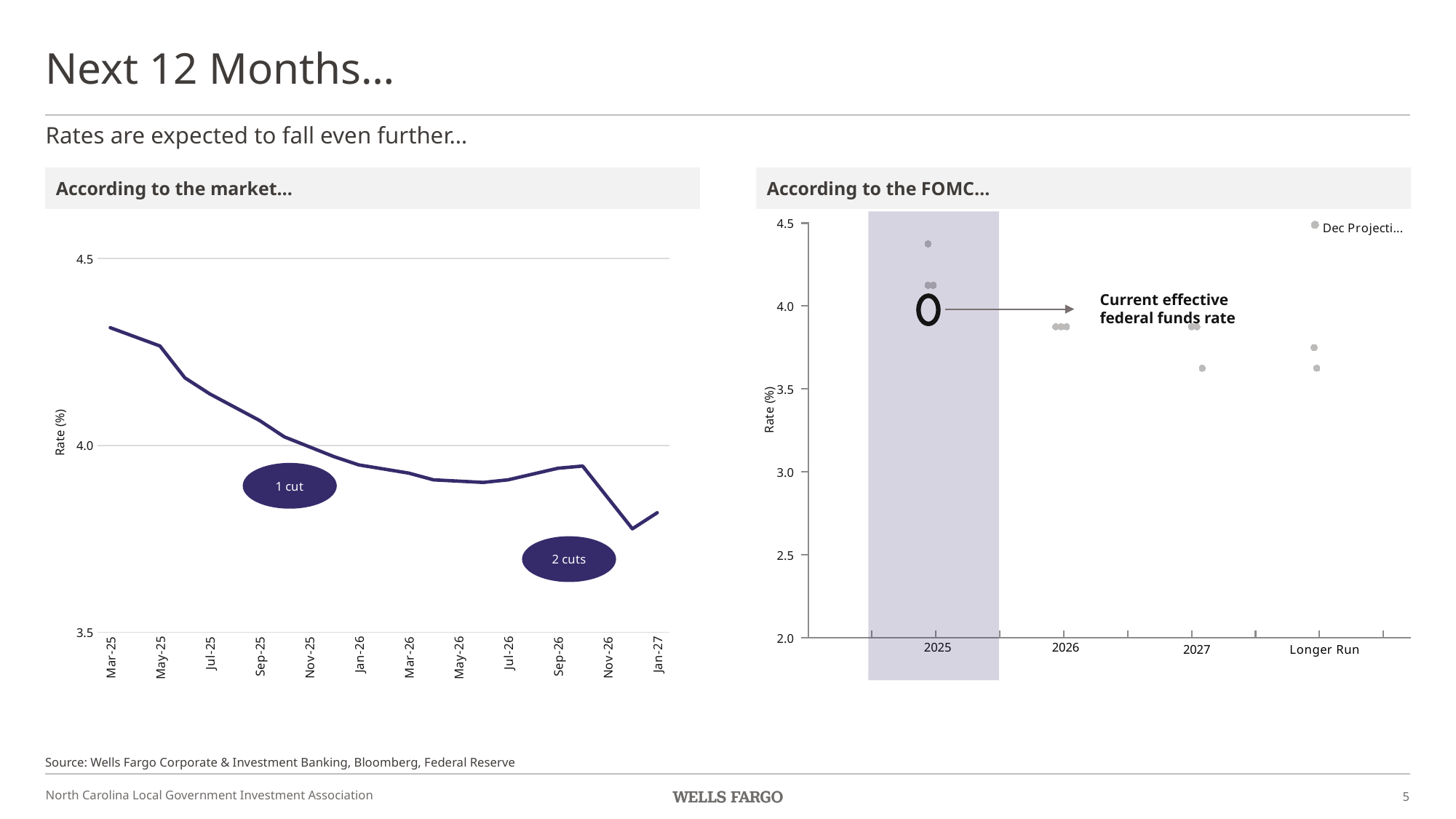
How many month labels are shown on the x axis of the 'According to the market...' chart? 12 How many categories are shown on the x axis of the 'According to the FOMC...' chart? 4 In the 'According to the market...' chart, is the value for Mar-25 greater or less than 4.0? greater In the 'According to the FOMC...' chart, which category contains the highest plotted dot? 2025 In the 'According to the market...' chart, which month has the highest rate? Mar-25 In the 'According to the market...' chart, do the values generally rise or fall from Mar-25 to Jan-27? fall In the 'According to the market...' chart, which is larger, the value for Mar-25 or the value for Jan-27? Mar-25 In the 'According to the FOMC...' chart, are the dots for Longer Run greater or less than 4.0? less In the 'According to the market...' chart, is the value for Nov-26 greater or less than 4.0? less What kind of chart is the 'According to the market...' chart? line chart What kind of chart is the 'According to the FOMC...' chart? scatter (dot) plot